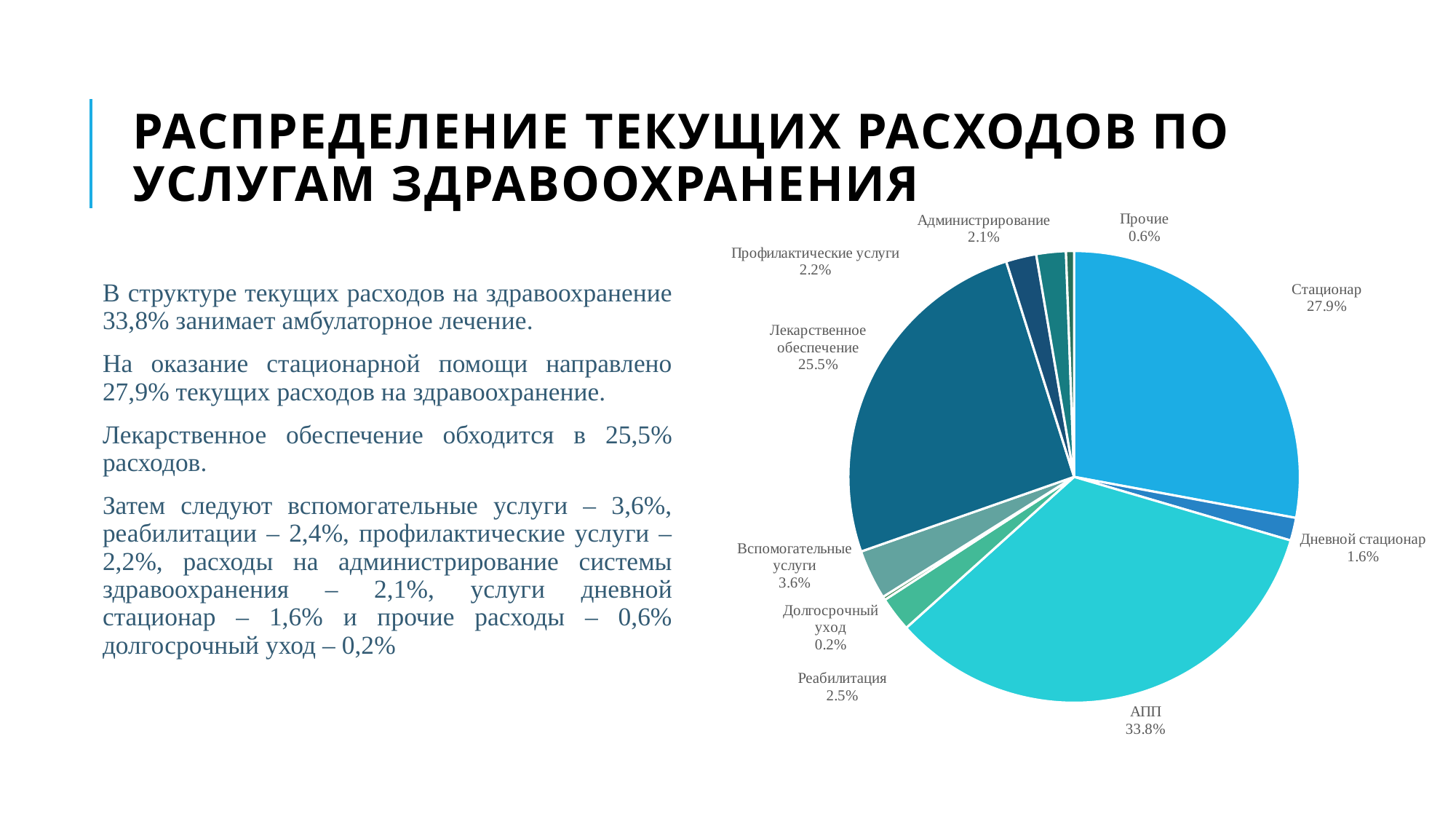
What percentage does the chart show for Реабилитация? 2.5% What is the value shown for Стационар in the pie chart? 27.9% What percentage is shown for Лекарственное обеспечение? 25.5% Which is larger, the share for Вспомогательные услуги or the share for Администрирование? Вспомогательные услуги What is the difference in percentage points between АПП and Стационар? 5.9 What is the difference in percentage points between Стационар and Лекарственное обеспечение? 2.4 What kind of chart is shown on the slide? pie chart How many categories (slices) does the pie chart have? 10 Which category has the smallest slice of the pie? Долгосрочный уход What share of current expenditure does АПП account for in the pie chart? 33.8% Which category has the largest slice of the pie? АПП What is the value labelled for Дневной стационар? 1.6%